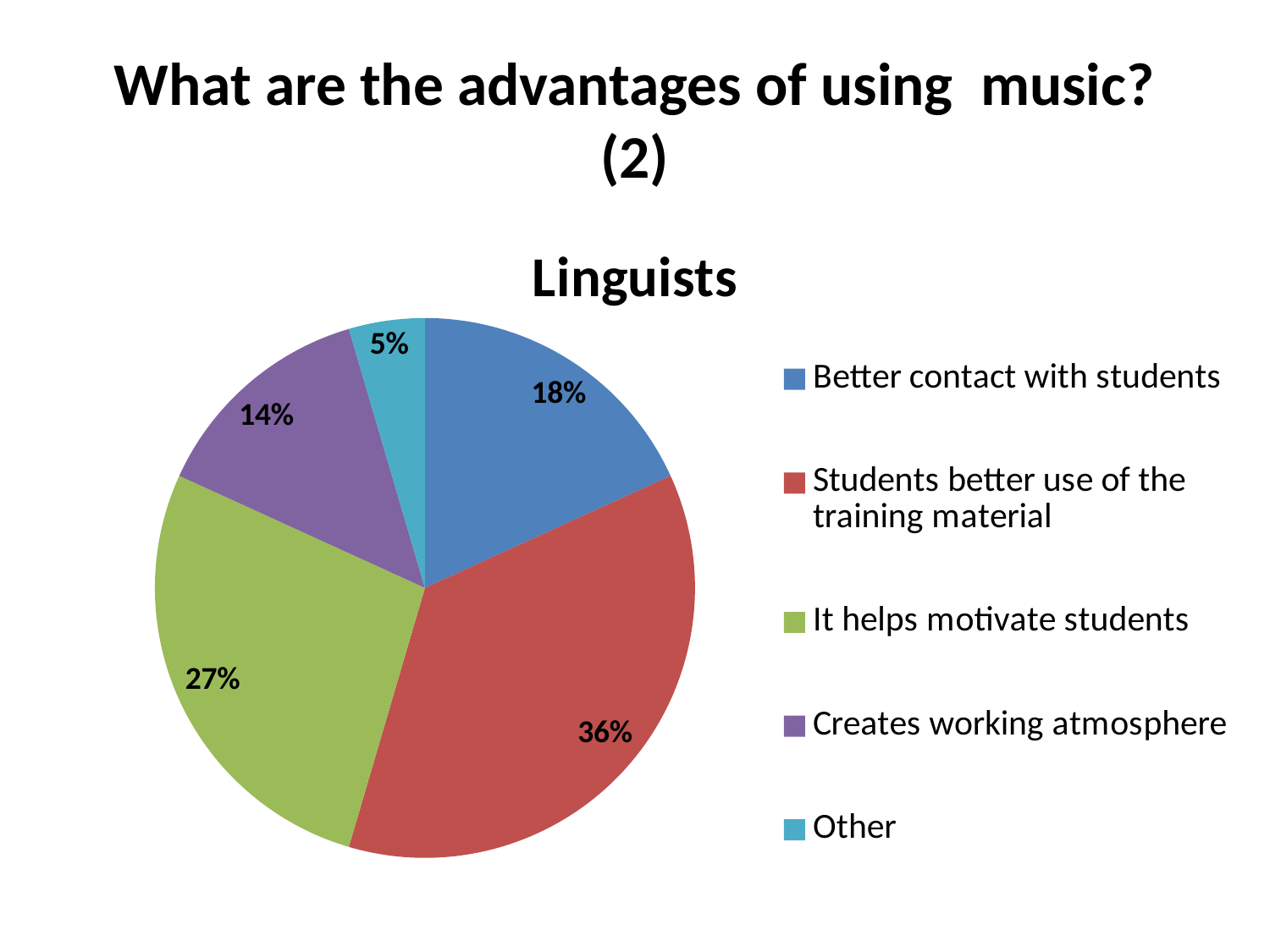
Which category has the largest slice of the pie? Students better use of the training material What share of the pie does 'Students better use of the training material' represent? 36% Which category has the smallest slice of the pie? Other What is the title of the chart? Linguists What kind of chart is shown on the slide? Pie chart What share of the pie does 'Creates working atmosphere' represent? 14% What is the difference in percentage points between 'Students better use of the training material' and 'It helps motivate students'? 9 What share of the pie does 'Other' represent? 5% What share of the pie does 'It helps motivate students' represent? 27% What share of the pie does 'Better contact with students' represent? 18% How many categories are shown in the pie chart? 5 Which is larger: 'Better contact with students' or 'Creates working atmosphere'? Better contact with students